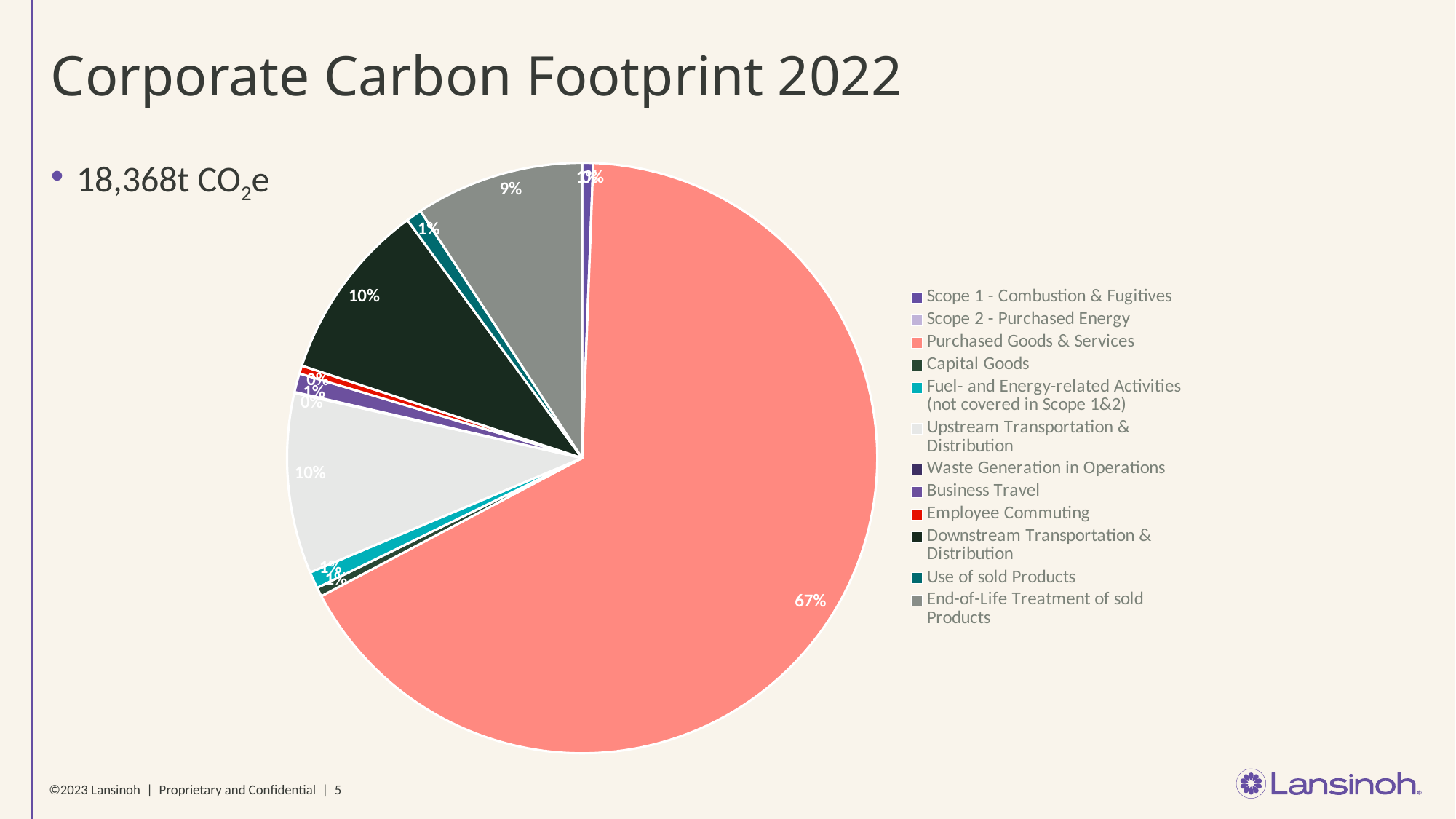
How many categories does the legend list? 12 What colour is the slice for Purchased Goods & Services? salmon pink Is the share for Purchased Goods & Services greater or less than 50%? greater What percentage is shown for End-of-Life Treatment of sold Products? 9% What is the title of the slide containing the pie chart? Corporate Carbon Footprint 2022 Which category has the largest slice of the pie? Purchased Goods & Services What percentage is shown for Downstream Transportation & Distribution? 10% What kind of chart is shown on the slide? pie chart What is the difference in percentage points between Purchased Goods & Services and End-of-Life Treatment of sold Products? 58 percentage points What share of the pie does Purchased Goods & Services account for? 67% Which is larger, the slice for Purchased Goods & Services or the slice for Downstream Transportation & Distribution? Purchased Goods & Services What percentage is shown for Upstream Transportation & Distribution? 10%